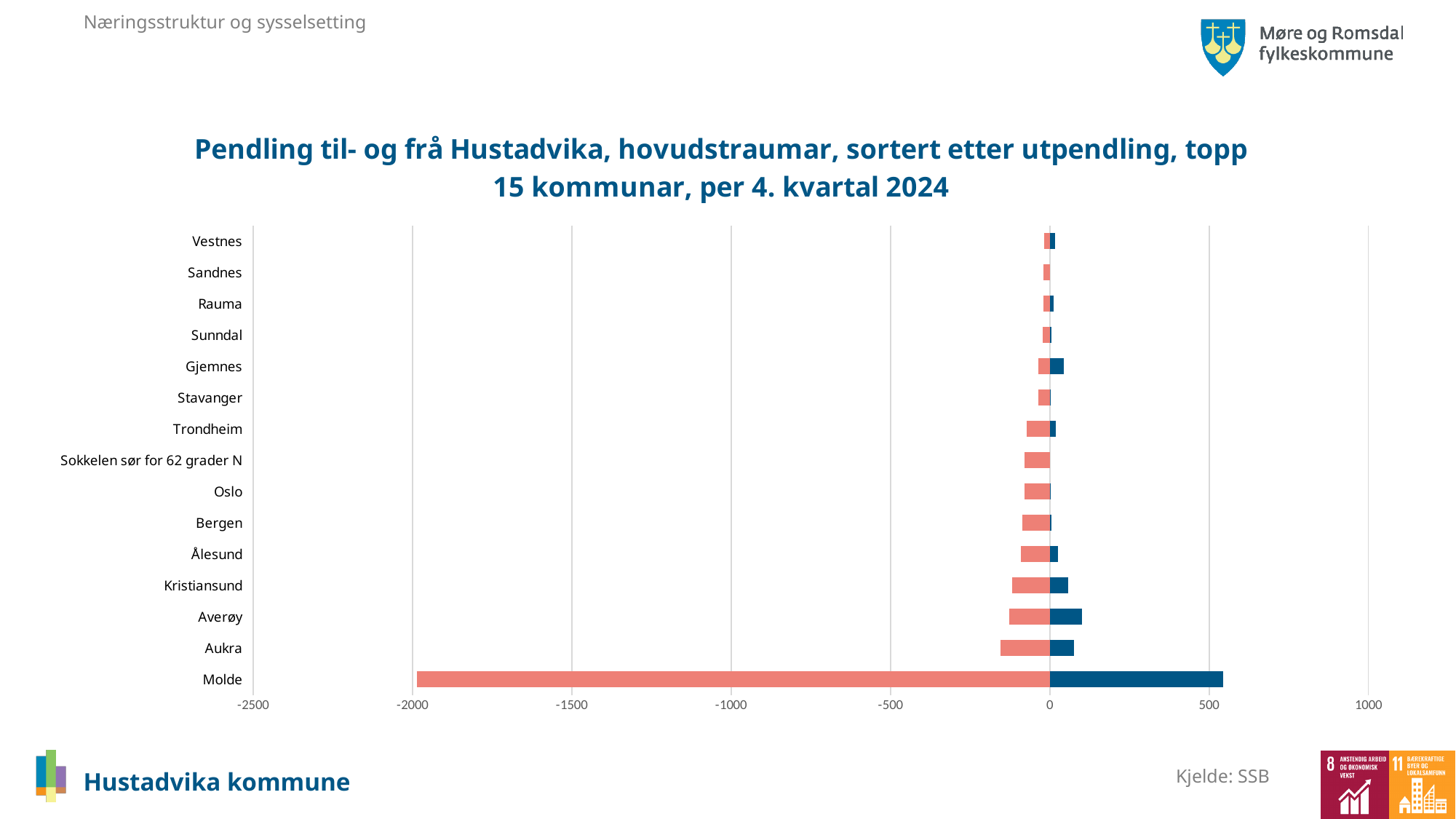
Which category has the longest blue (positive, inbound commuting) bar? Molde Is the blue bar for Averøy greater or less than 500 on the axis? less What source is cited for the chart data (Kjelde)? SSB Which has the longer red bar, Aukra or Vestnes? Aukra How many municipalities/categories are listed on the vertical axis of the chart? 15 Is the red bar for Aukra greater or less than -500 on the axis? greater Is the red bar for Molde greater or less than -1500 on the axis? less Which category is listed at the bottom of the vertical axis? Molde Which category has the longest red (negative, outbound commuting) bar? Molde Which has the longer blue bar, Molde or Averøy? Molde What kind of chart is shown on the slide? bar chart